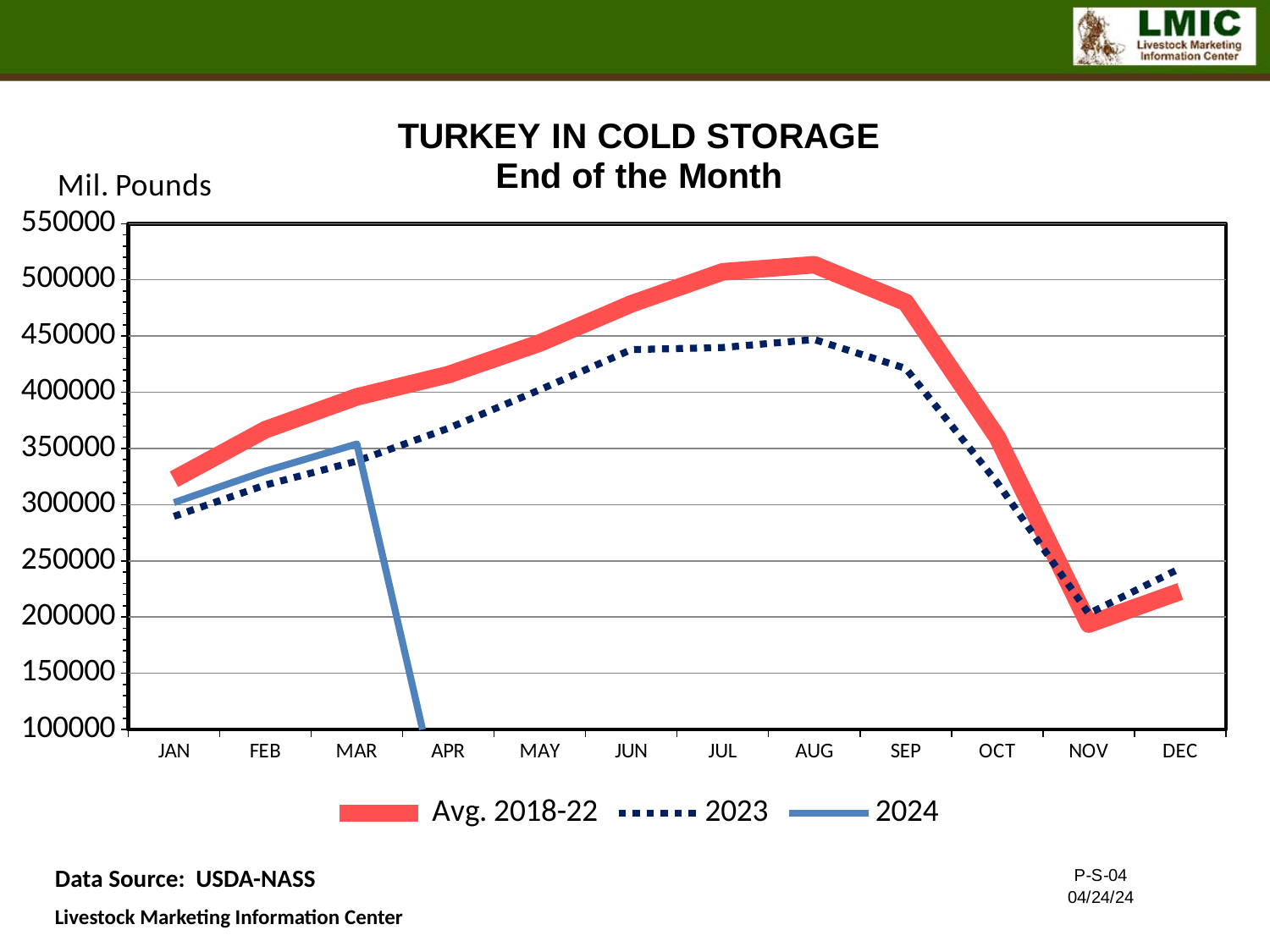
Is the Avg. 2018-22 value for AUG greater or less than 500000? greater What kind of chart is shown on the slide? line chart Is the 2024 value for FEB greater or less than 300000? greater How many series does the legend list? 3 In which month does the Avg. 2018-22 series reach its lowest value? NOV Is the 2023 value for JUN greater or less than 400000? greater Does the Avg. 2018-22 series rise or fall from AUG to NOV? fall What unit label is shown above the y axis? Mil. Pounds In JUL, which series has the larger value, Avg. 2018-22 or 2023? Avg. 2018-22 In which month does the 2023 series reach its highest value? AUG In which month does the Avg. 2018-22 series reach its highest value? AUG How many months are shown on the x axis? 12